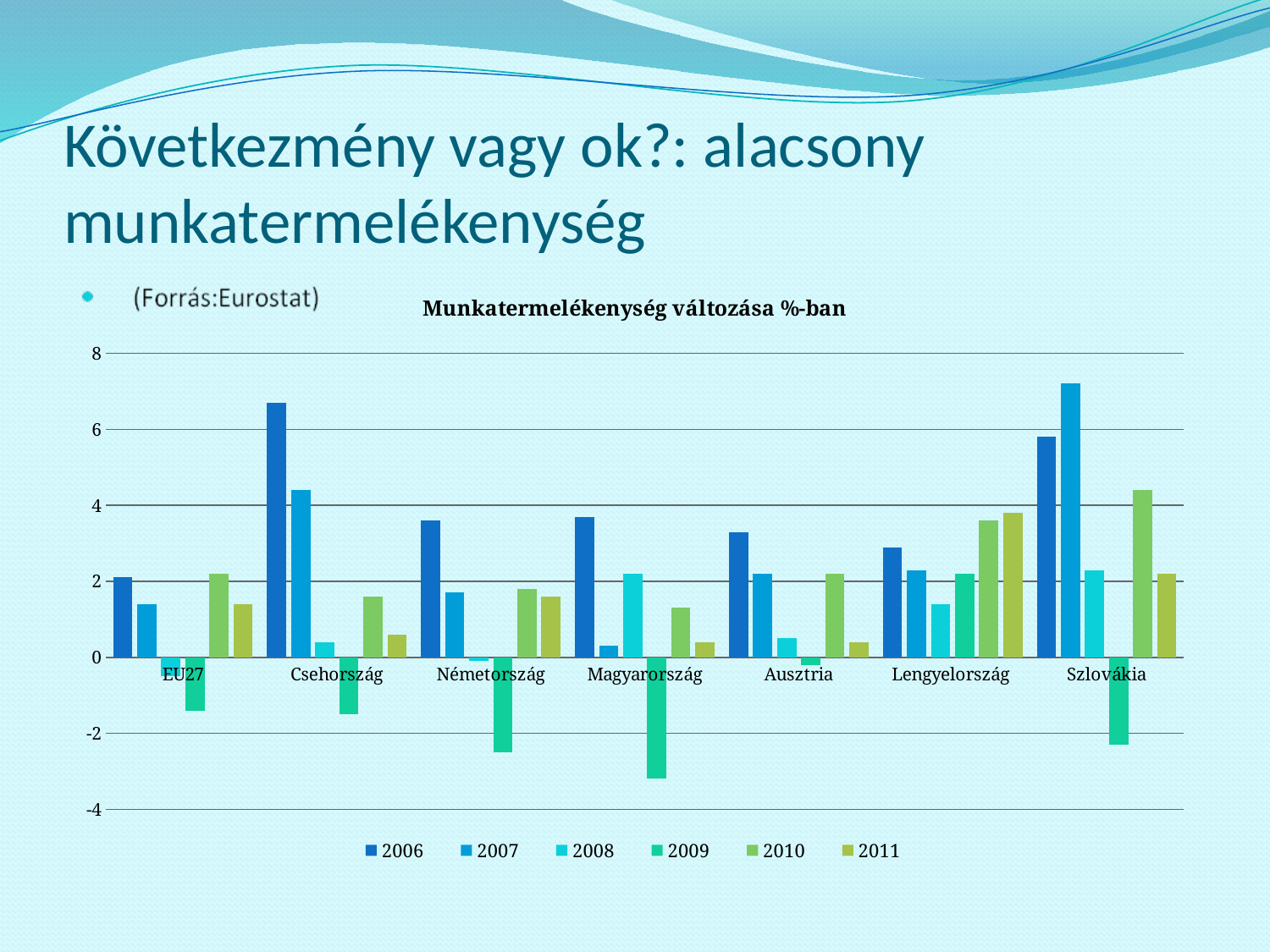
Which country and year has the highest bar in the chart? Szlovákia, 2007 What is the title of the chart? Munkatermelékenység változása %-ban Which country is the only one with a clearly positive 2009 value? Lengyelország Is the 2009 value for Magyarország greater or less than -2? less How many series does the legend list? 6 Which country and year has the lowest bar in the chart? Magyarország, 2009 Is the 2006 value for Csehország greater or less than 6? greater Which has the larger 2010 value, Szlovákia or Lengyelország? Szlovákia Is the 2007 value for Szlovákia greater or less than 6? greater What kind of chart is shown on the slide? bar chart Which has the larger 2006 value, Csehország or Németország? Csehország How many countries/regions are shown on the x axis? 7